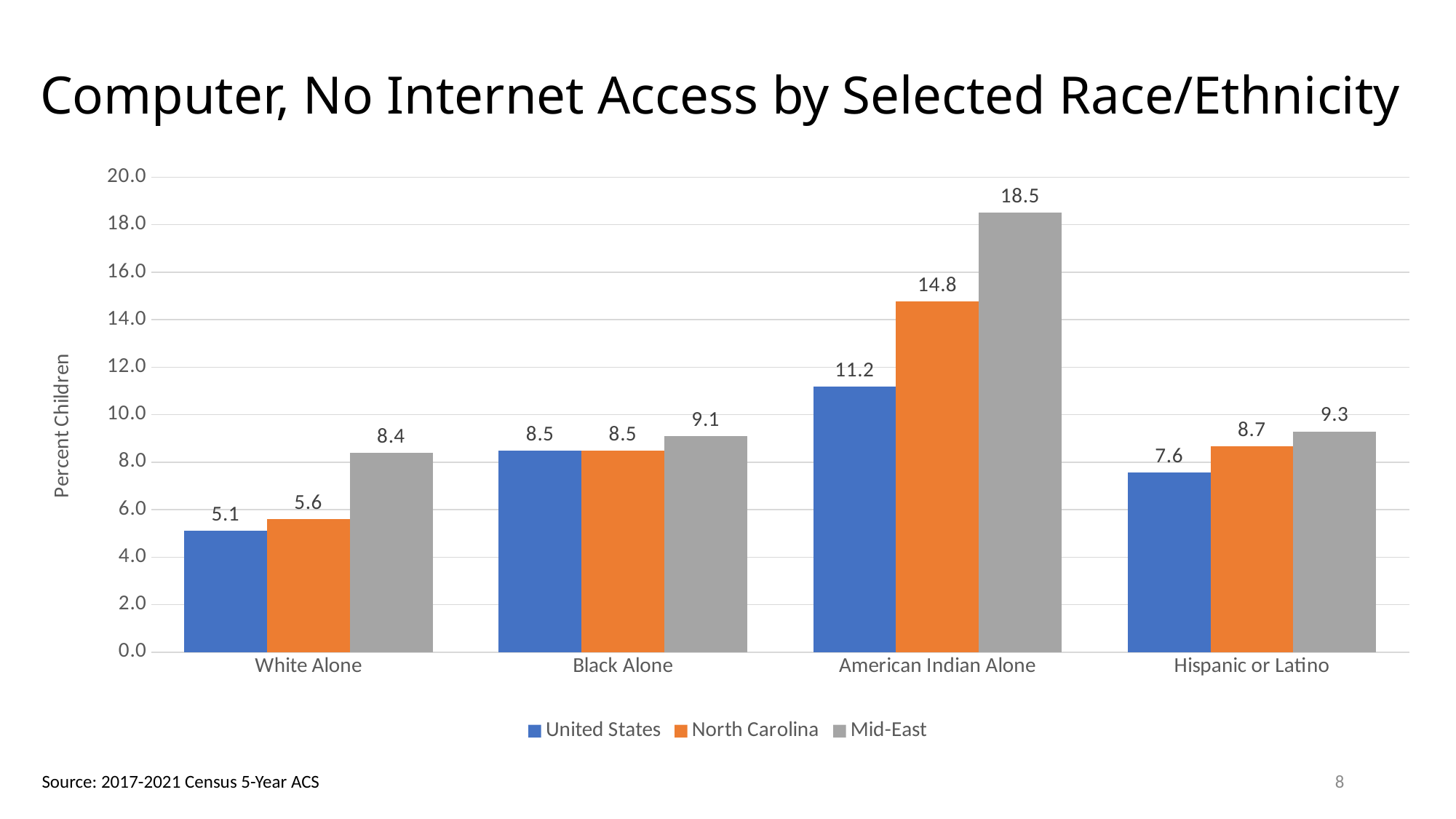
What is the Mid-East value for American Indian Alone? 18.5 What kind of chart is shown on the slide? Bar chart How many race/ethnicity categories are shown on the x axis? 4 Which race/ethnicity category has the highest Mid-East value? American Indian Alone What is the label on the vertical axis? Percent Children What colour represents North Carolina in the chart? Orange What is the North Carolina value for Hispanic or Latino? 8.7 How many series does the legend list? 3 What is the difference between the Mid-East and United States values for American Indian Alone? 7.3 Which race/ethnicity category has the lowest United States value? White Alone What is the United States value for White Alone? 5.1 Which is larger for Black Alone: the Mid-East value or the United States value? Mid-East